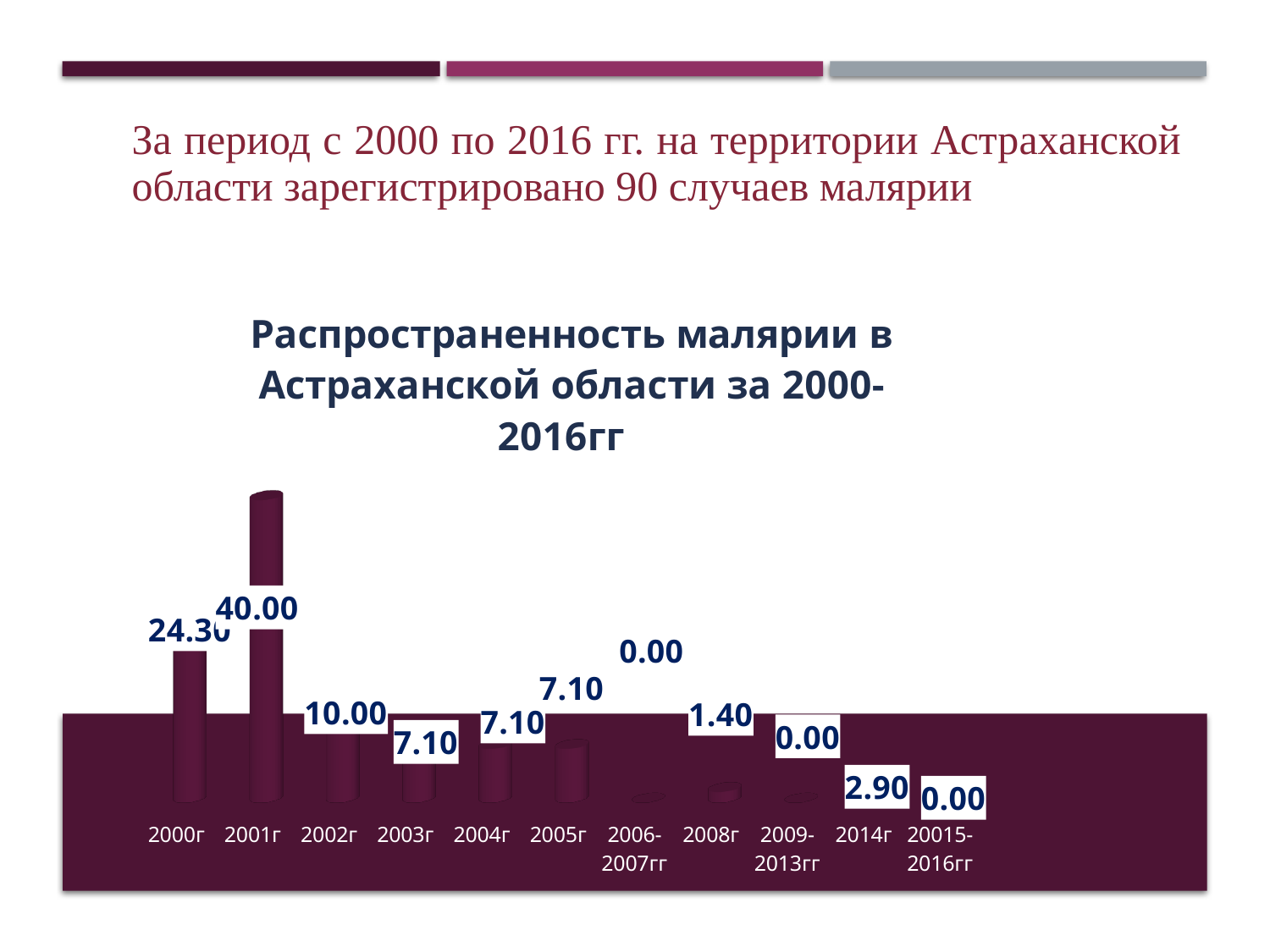
What type of chart is shown on the slide? bar chart What is the value for 2002г? 10.00 What is the difference between the values for 2001г and 2002г? 30.00 What is the value for 2001г? 40.00 Which category has the highest value? 2001г How many categories are shown on the x axis? 11 What is the value for 2014г? 2.90 What is the value for 2008г? 1.40 What is the title of the chart? Распространенность малярии в Астраханской области за 2000-2016гг Which is larger, the value for 2002г or the value for 2003г? 2002г What is the difference between the values for 2014г and 2008г? 1.50 What is the value for 2009-2013гг? 0.00